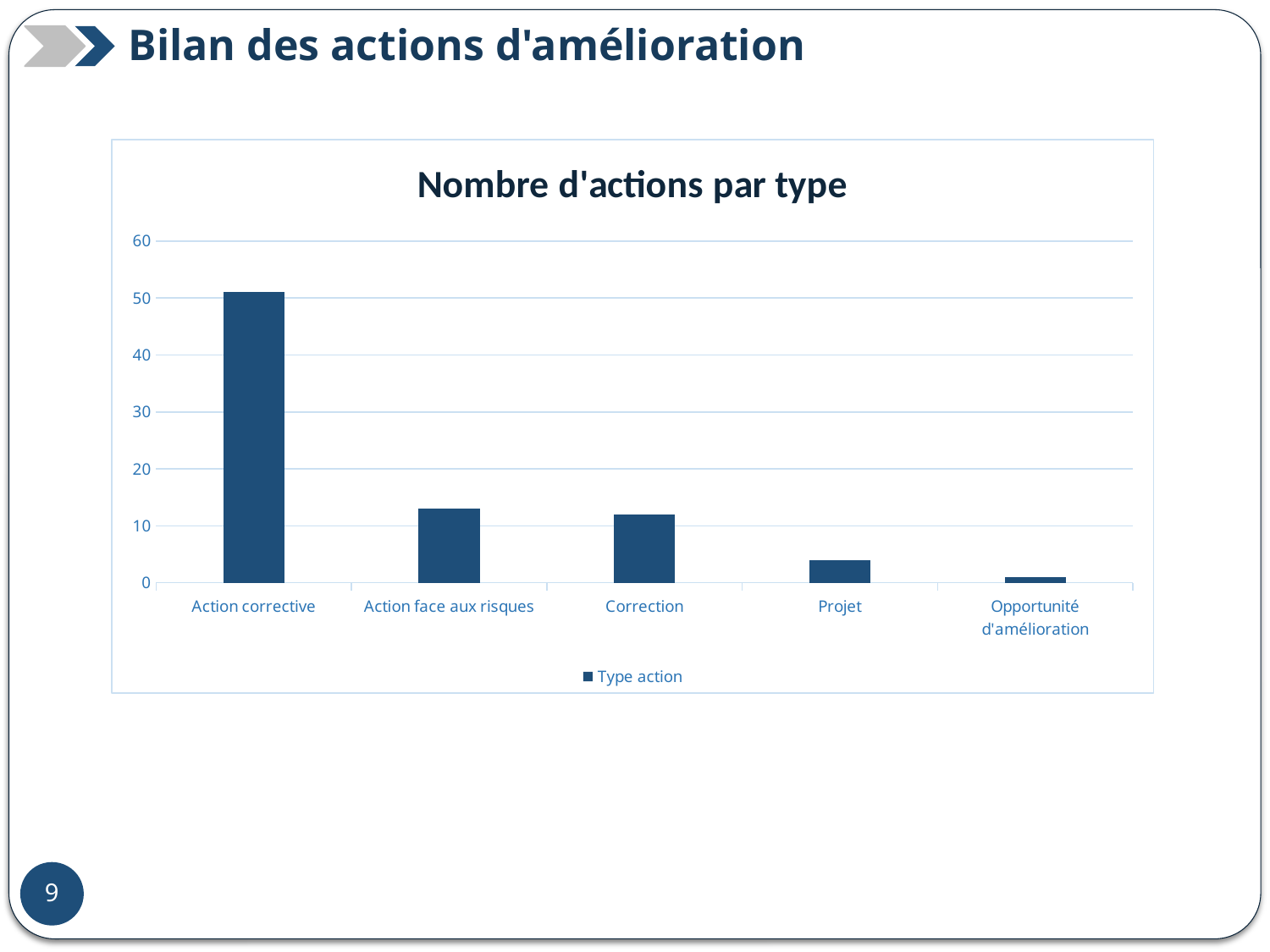
Is the value for Action face aux risques greater or less than 10? greater Which category has the highest value? Action corrective How many series does the chart legend list? 1 Which is larger, the value for Action corrective or the value for Correction? Action corrective What type of chart is shown on the slide? bar chart What is the title of the chart? Nombre d'actions par type Is the value for Projet greater or less than 10? less How many categories are shown on the x axis of the chart? 5 What is the name of the series shown in the legend? Type action Which is larger, the value for Projet or the value for Opportunité d'amélioration? Projet Which category has the lowest value? Opportunité d'amélioration